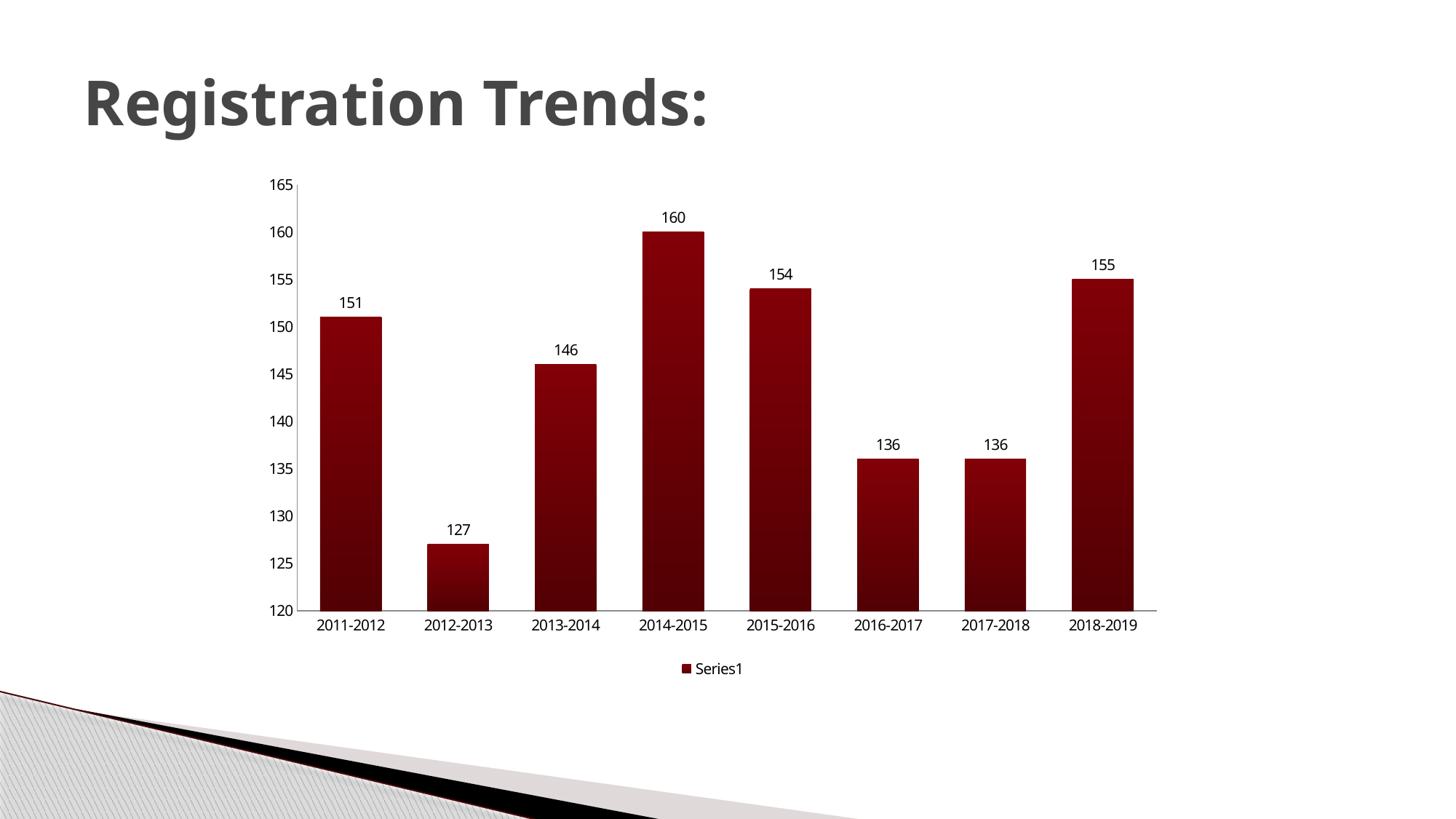
Which is larger, the value for 2011-2012 or the value for 2013-2014? 2011-2012 Is the value for 2015-2016 greater or less than 150? greater What is the value for 2012-2013? 127 Which year has the highest value? 2014-2015 What is the value for 2014-2015? 160 How many series does the legend list? 1 What kind of chart is shown on the slide? bar chart How many years are shown on the x axis? 8 Which year has the lowest value? 2012-2013 What is the difference between the values for 2014-2015 and 2012-2013? 33 What is the title of the slide? Registration Trends: What is the value for 2018-2019? 155